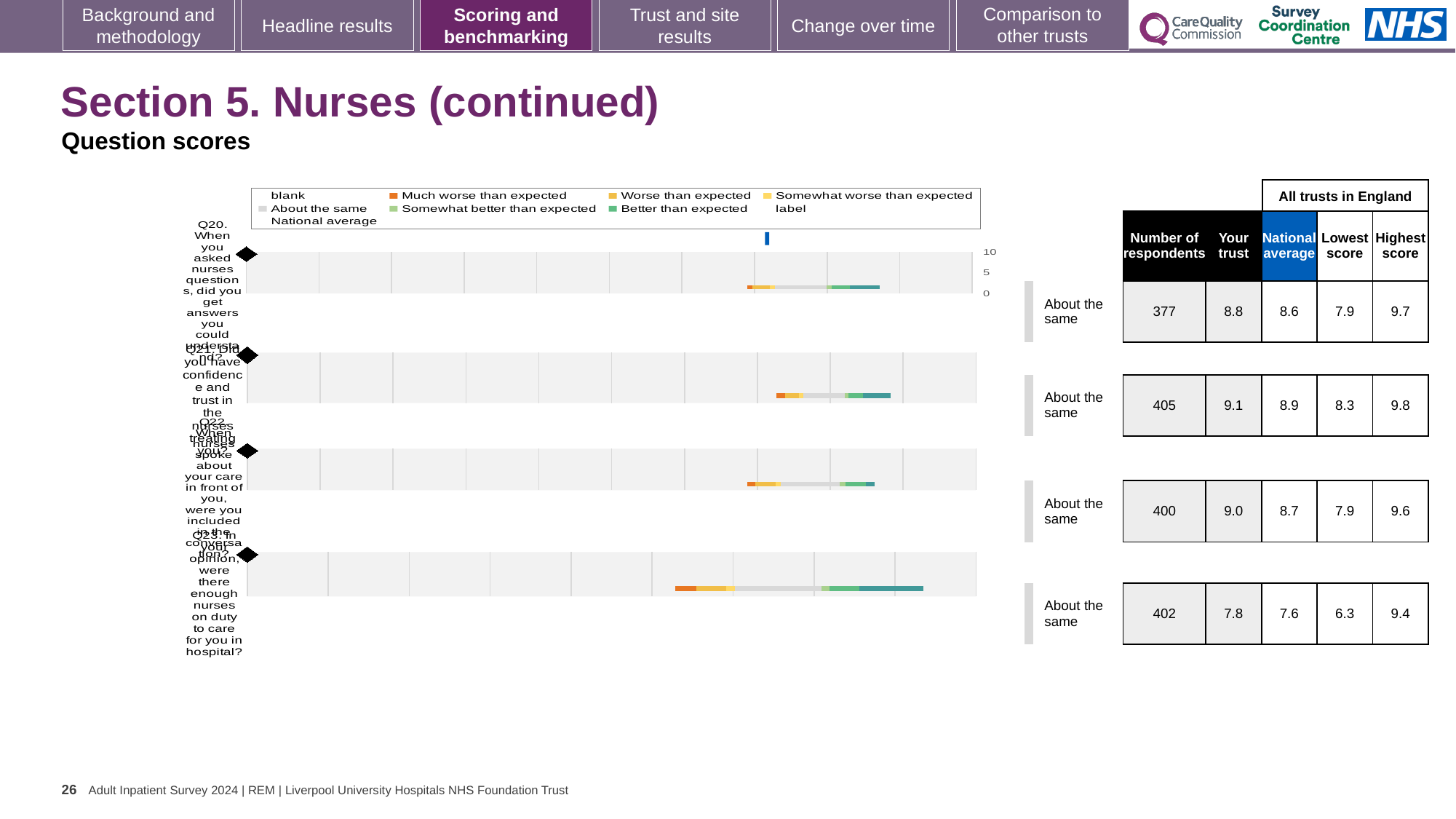
For Q21, how much higher is the 'Your trust' score than the national average? 0.2 What kind of chart is used to show the question scores for Q20 to Q23? bar chart According to the table beside the chart, what is the national average for Q23? 7.6 How many questions (categories) are plotted in the chart? 4 What benchmark category is shown next to the chart for Q22? About the same Which colour does the legend use for 'Much worse than expected'? orange According to the table beside the chart, what is the 'Your trust' score for Q21? 9.1 For Q20, which is larger: the 'Your trust' score or the national average? Your trust Which question has the highest 'Your trust' score in the table beside the chart? Q21 According to the table beside the chart, how many respondents answered Q20? 377 For Q23, what is the difference between the highest score and the lowest score across all trusts in England? 3.1 Which question has the lowest 'Your trust' score in the table beside the chart? Q23